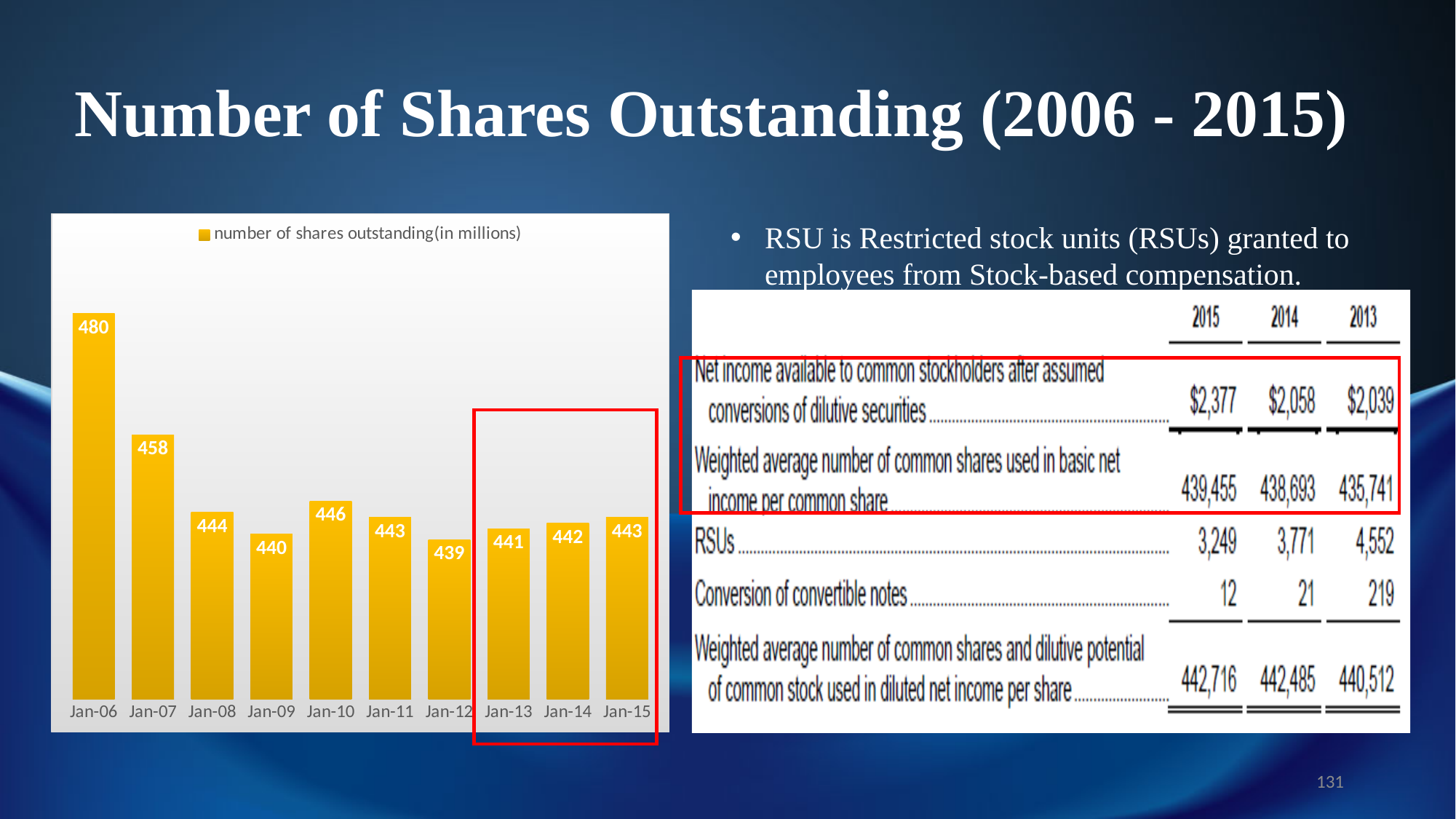
How many series does the chart legend list? 1 Which year has the highest number of shares outstanding? Jan-06 What is the number of shares outstanding (in millions) for Jan-14? 442 What is the difference in shares outstanding between Jan-06 and Jan-07? 22 What kind of chart is shown on the slide? bar chart Which year has the lowest number of shares outstanding? Jan-12 Which is larger, the number of shares outstanding for Jan-08 or for Jan-09? Jan-08 How many years are shown on the x axis of the chart? 10 What is the number of shares outstanding (in millions) for Jan-06? 480 What is the difference in shares outstanding between Jan-10 and Jan-09? 6 What is the legend entry of the chart? number of shares outstanding(in millions) What is the number of shares outstanding (in millions) for Jan-12? 439